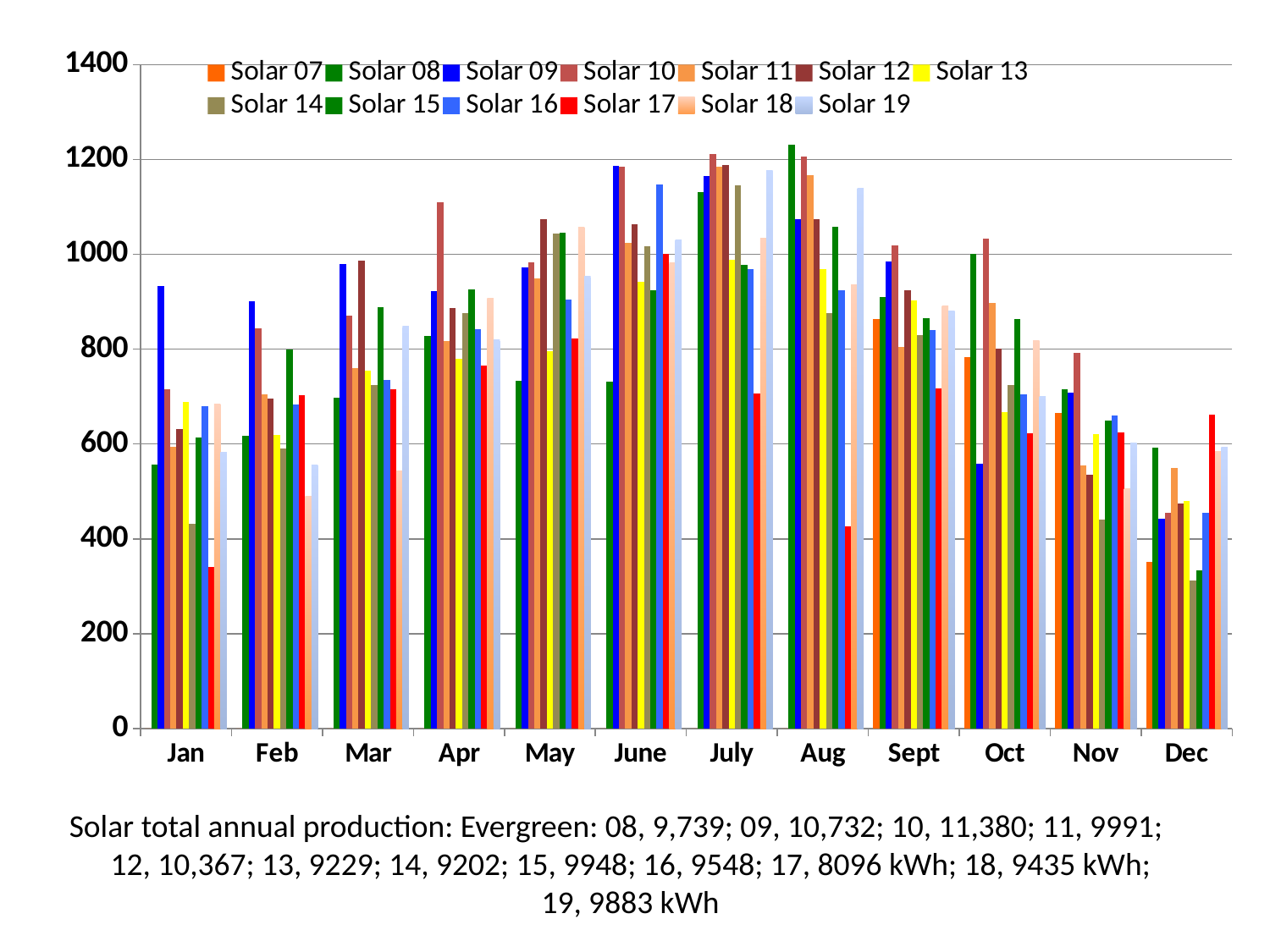
Which series has the lowest value in Jan? Solar 17 Is the value for Solar 17 in Aug greater or less than 600? less Do the values for Solar 19 rise or fall from Aug to Dec? fall In Aug, which is larger: Solar 19 or Solar 17? Solar 19 What kind of chart is shown on the slide? bar chart How many months are shown along the x axis? 12 Is the value for Solar 19 in Aug greater or less than 1000? greater Which series has the highest value in Jan? Solar 09 Is the value for Solar 17 in Jan greater or less than 400? less How many series does the legend list? 13